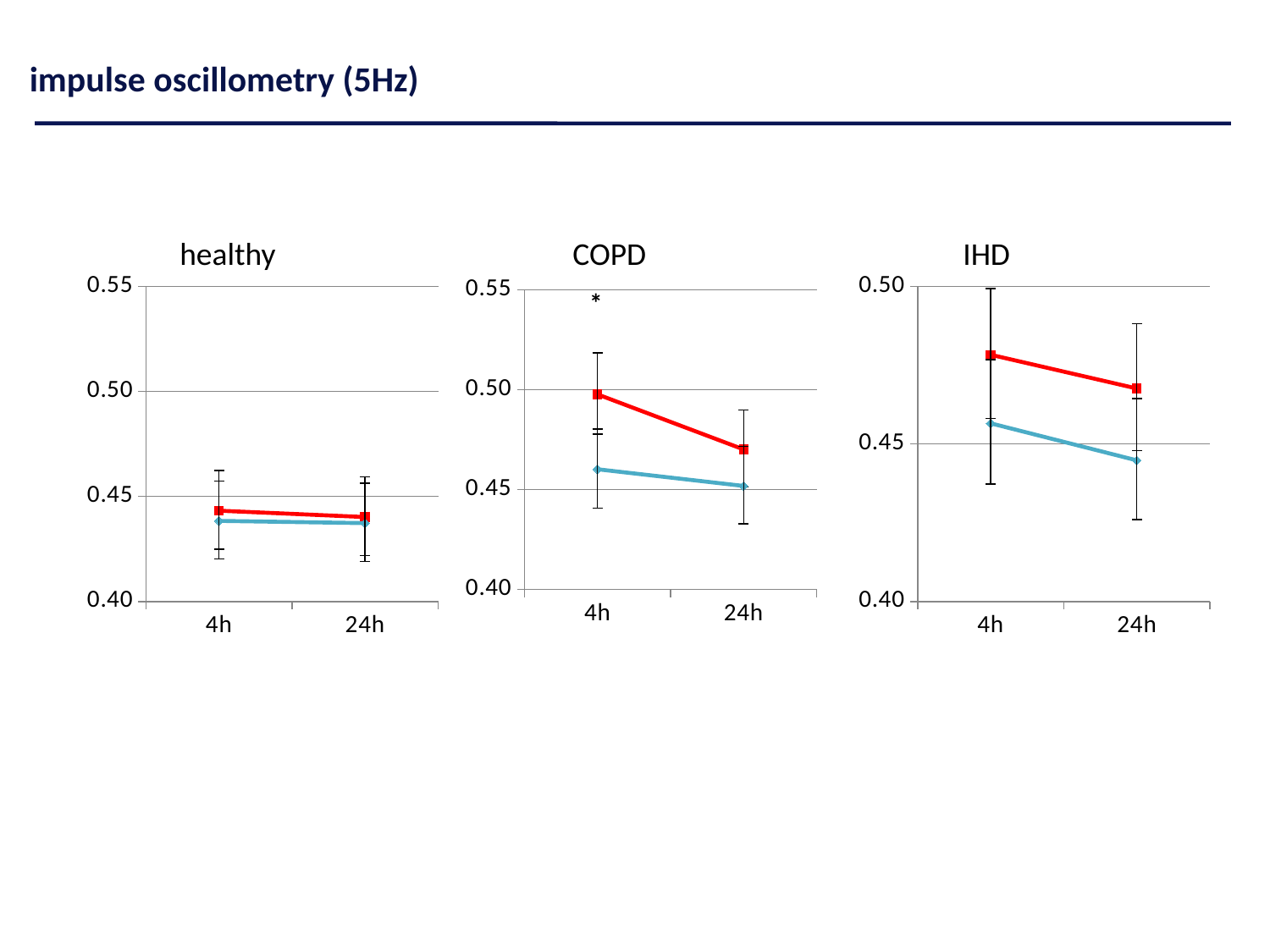
What kind of chart is the COPD chart? line chart In the COPD chart at 4h, which series has the higher value, the red or the blue? red How many charts are shown on the slide? 3 In the COPD chart, does the red series rise or fall from 4h to 24h? fall What is the title of the chart on the right of the slide? IHD In the IHD chart, is the value of the blue series at 24h greater or less than 0.45? less How many time points are shown on the x axis of the healthy chart? 2 In the IHD chart, does the blue series rise or fall from 4h to 24h? fall In the IHD chart at 4h, which series has the higher value, the red or the blue? red In the COPD chart, is the value of the red series at 24h greater or less than 0.45? greater In the healthy chart, is the value of the red series at 4h greater or less than 0.45? less